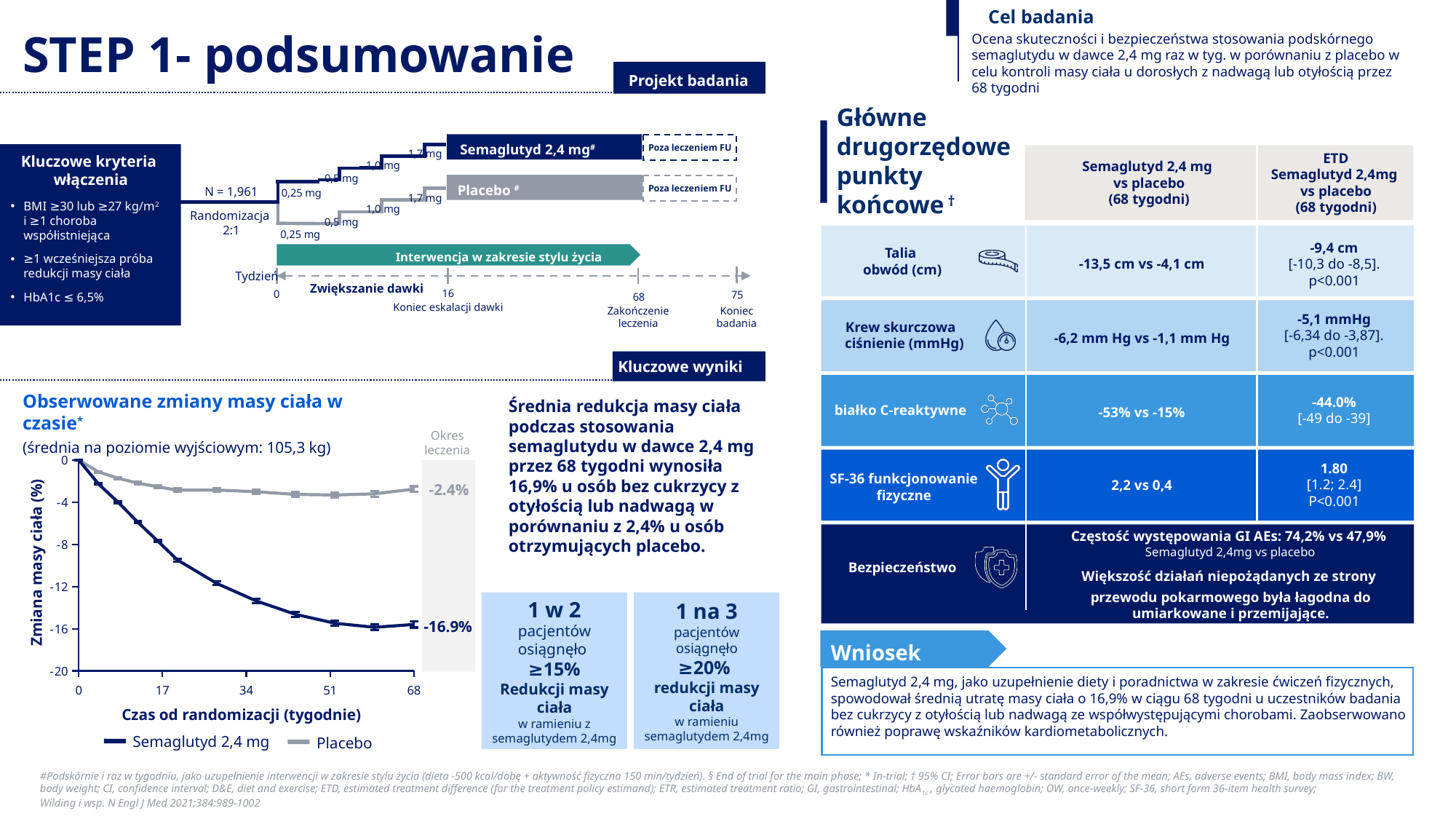
In the body-weight change chart, what is the value for Semaglutyd 2,4 mg at week 68? -16.9% In the body-weight change chart, is the Semaglutyd 2,4 mg value at week 51 greater or less than -12? less What baseline mean body weight is stated under the title of the body-weight change chart? 105,3 kg How many tick labels are shown on the x axis of the body-weight change chart? 5 In the body-weight change chart, what is the value for Placebo at week 68? -2.4% In the body-weight change chart, does the Semaglutyd 2,4 mg line rise or fall from week 0 to week 68? fall How many series does the legend of the body-weight change chart list? 2 What kind of chart is 'Obserwowane zmiany masy ciała w czasie'? line chart In the body-weight change chart, which series shows the greater weight reduction at week 68? Semaglutyd 2,4 mg In the body-weight change chart, what is the difference between the Semaglutyd 2,4 mg and Placebo values at week 68? 14.5 percentage points In the body-weight change chart, is the Placebo value at week 34 greater or less than -4? greater What is the y-axis label of the body-weight change chart? Zmiana masy ciała (%)